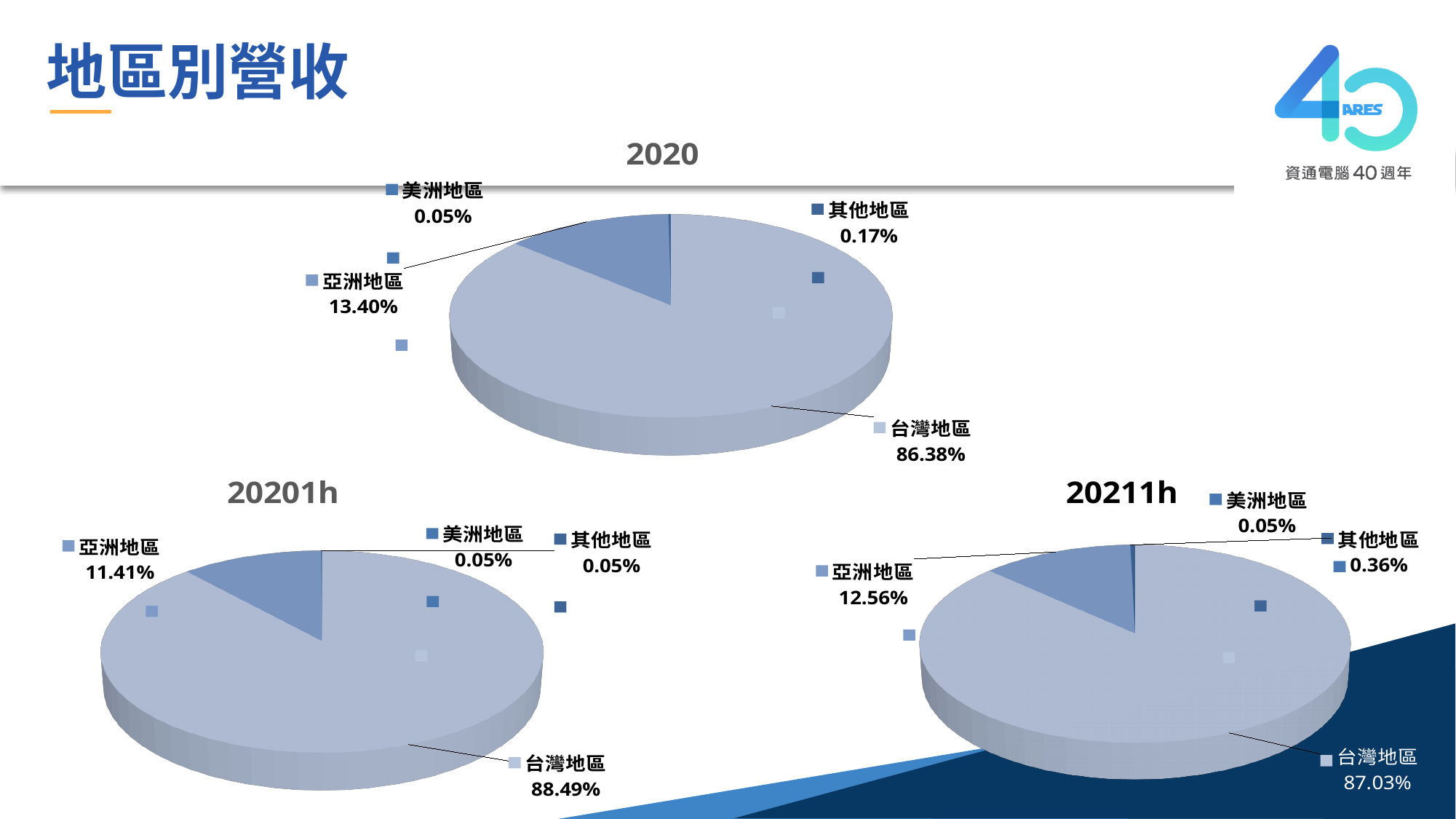
In the 20201h pie chart, which region has the largest share? 台灣地區 In the 2020 pie chart, what share does 亞洲地區 have? 13.40% In the 20211h pie chart, what is the difference between the shares of 台灣地區 and 亞洲地區? 74.47% In the 2020 pie chart, what share does 台灣地區 have? 86.38% How many regions are shown in the 20201h pie chart? 4 In the 2020 pie chart, which region has the smallest share? 美洲地區 In the 20211h pie chart, what share does 台灣地區 have? 87.03% How many pie charts are on the slide? 3 What type of chart is used for the 2020 data? Pie chart In the 20211h pie chart, what share does 其他地區 have? 0.36% Which is larger: the share of 亞洲地區 in 2020 or in 20211h? 2020 In the 20201h pie chart, what share does 亞洲地區 have? 11.41%